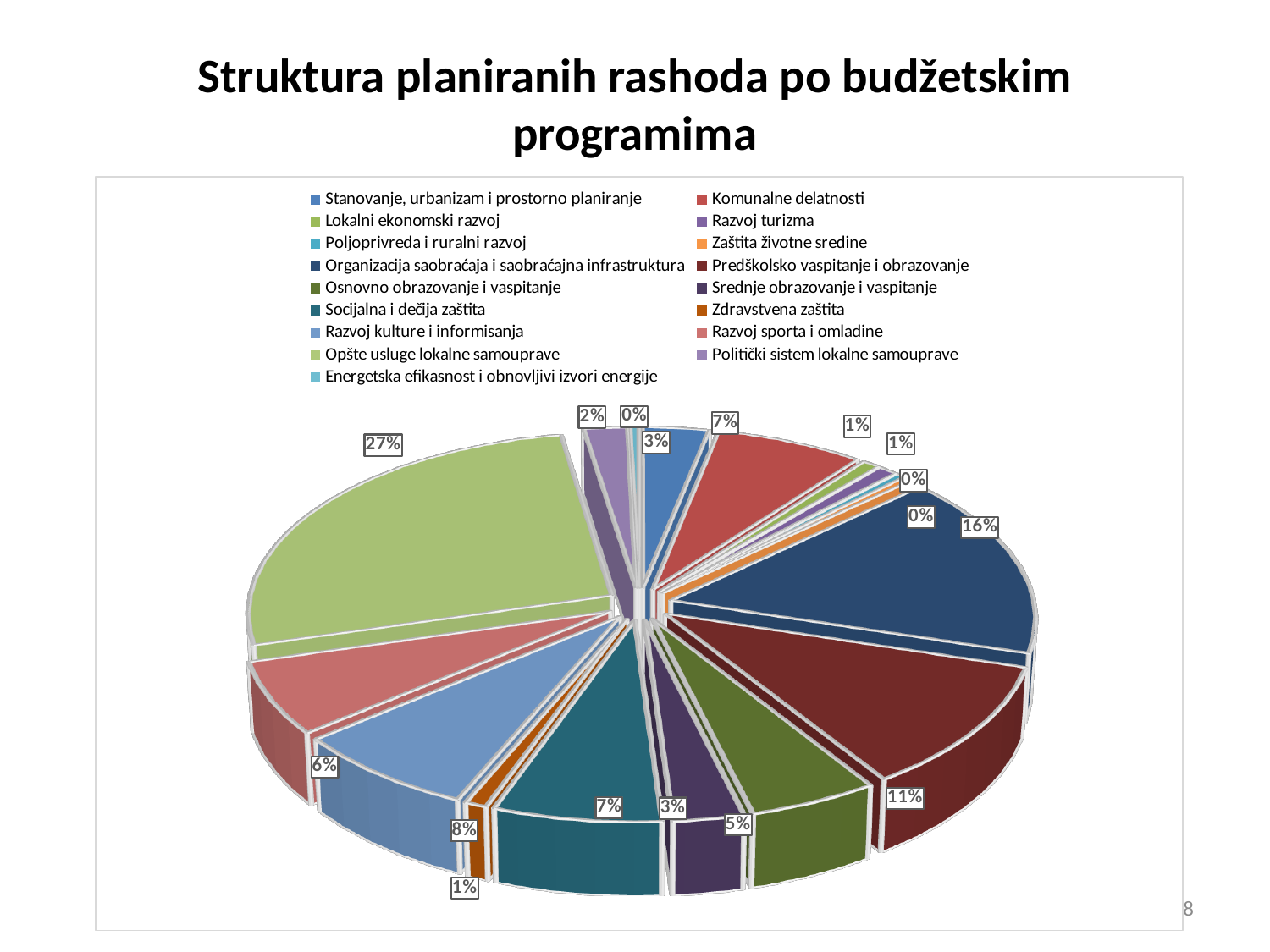
What is the title of the chart? Struktura planiranih rashoda po budžetskim programima What share of planned expenditures goes to Predškolsko vaspitanje i obrazovanje? 11% How many budget programmes are listed in the legend? 17 Which has a larger share: Organizacija saobraćaja i saobraćajna infrastruktura or Predškolsko vaspitanje i obrazovanje? Organizacija saobraćaja i saobraćajna infrastruktura What share of planned expenditures goes to Razvoj kulture i informisanja? 8% What is the difference in percentage points between the share for Opšte usluge lokalne samouprave and the share for Organizacija saobraćaja i saobraćajna infrastruktura? 11 percentage points What kind of chart is shown on the slide? pie chart What share of planned expenditures goes to Razvoj sporta i omladine? 6% Which budget programme has the largest share of planned expenditures? Opšte usluge lokalne samouprave